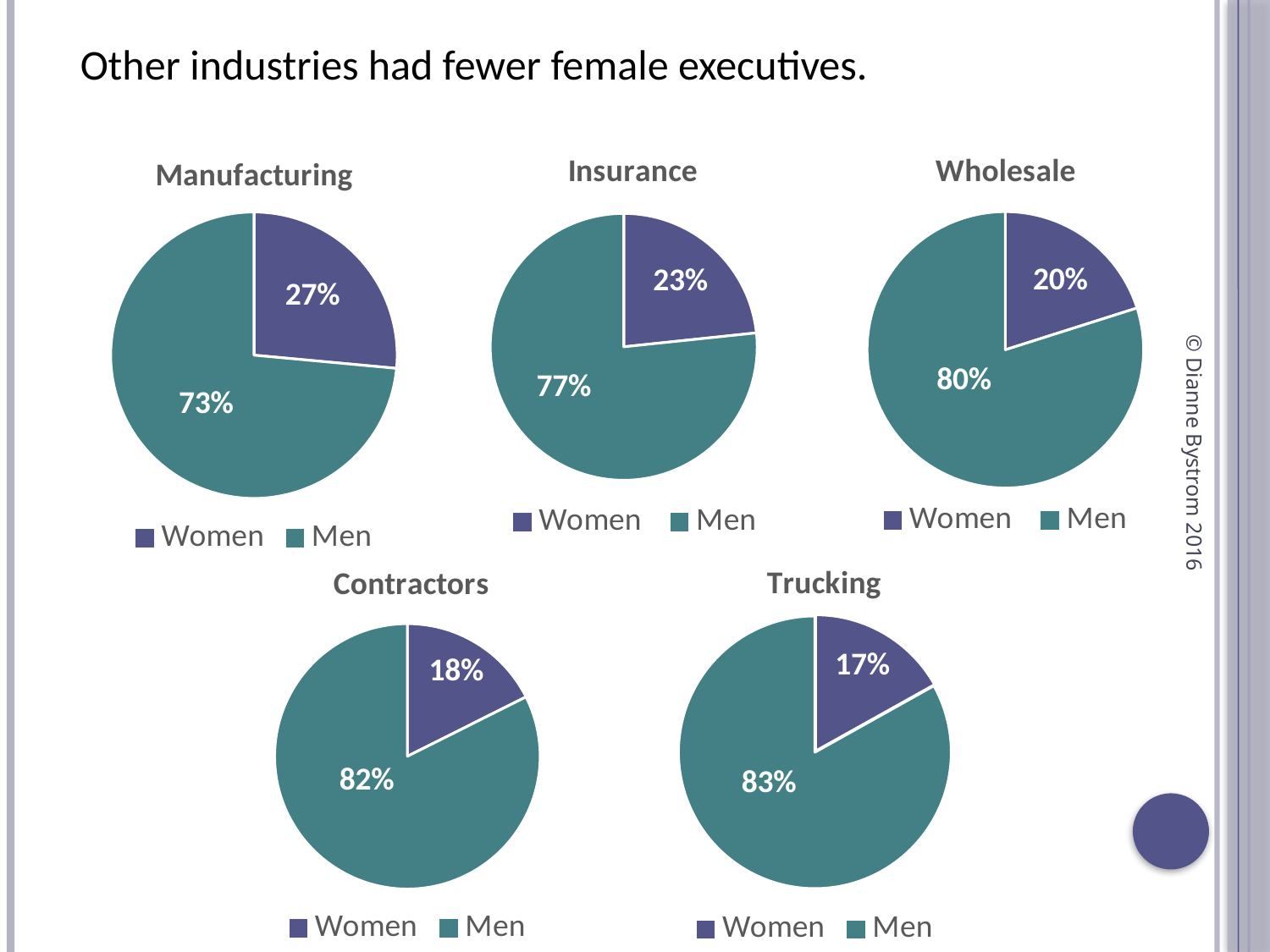
How many slices does the Wholesale pie chart have? 2 In the Insurance chart, what share of executives are men? 77% How many pie charts are shown on the slide? 5 In the Contractors chart, what percentage is shown for men? 82% In the Contractors chart, what is the difference between the Men and Women percentages? 64% In the Trucking chart, what share of executives are women? 17% In the Manufacturing chart, what share of executives are women? 27% In the Manufacturing chart, what is the difference between the Men and Women percentages? 46% In the Trucking chart, which slice is larger, Women or Men? Men What kind of chart is the Insurance chart? Pie chart In the Wholesale chart, what percentage is shown for women? 20% How many entries does the legend of the Trucking chart list? 2